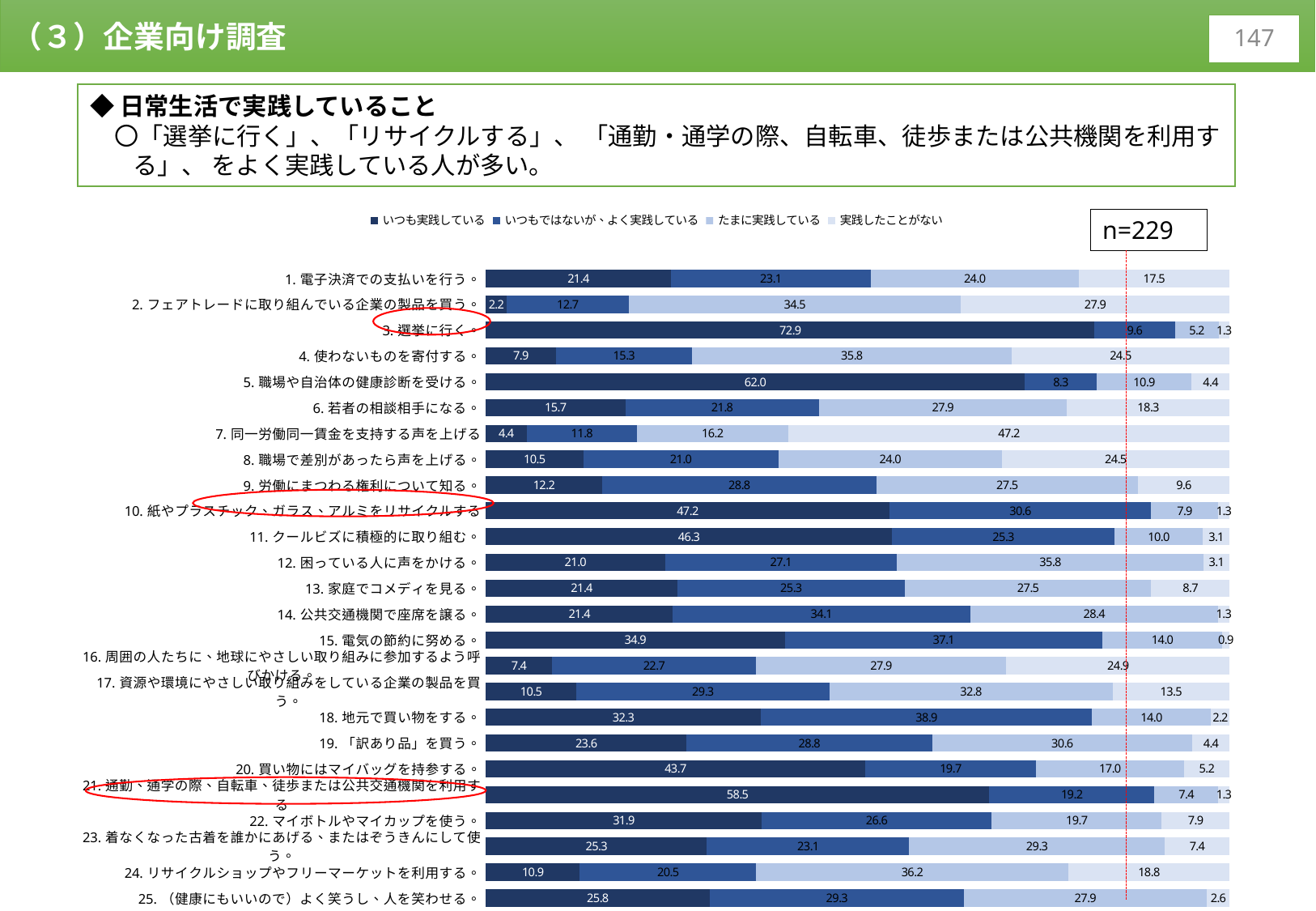
Which item has the lowest value for いつも実践している? 2. フェアトレードに取り組んでいる企業の製品を買う What is the value of いつも実践している for 3. 選挙に行く? 72.9 Which item has the highest value for いつも実践している? 3. 選挙に行く What type of chart is shown on the slide? stacked bar chart What is the value of いつも実践している for 5. 職場や自治体の健康診断を受ける? 62.0 What is the difference in いつも実践している between 3. 選挙に行く and 5. 職場や自治体の健康診断を受ける? 10.9 How many categories (items) are plotted in the chart? 25 How many series does the legend list? 4 What sample size (n) is shown on the chart? n=229 What is the value of 実践したことがない for 7. 同一労働同一賃金を支持する声を上げる? 47.2 What is the value of いつもではないが、よく実践している for 18. 地元で買い物をする? 38.9 Which has a larger いつも実践している value: 10. 紙やプラスチック、ガラス、アルミをリサイクルする or 20. 買い物にはマイバッグを持参する? 10. 紙やプラスチック、ガラス、アルミをリサイクルする